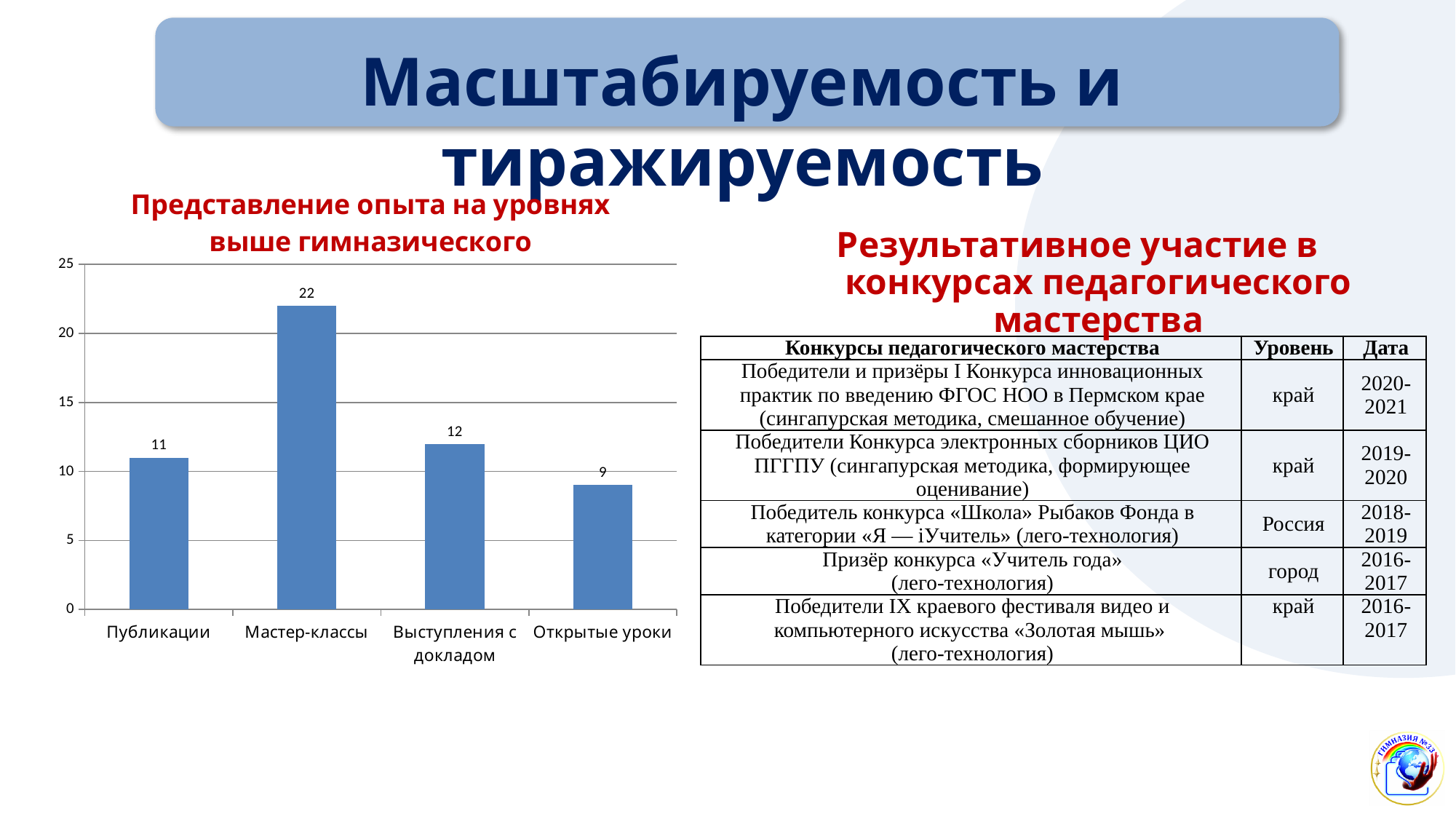
What is the value for Публикации? 11 What is the value for Мастер-классы? 22 What kind of chart is shown on the slide? Bar chart How many categories are shown in the chart? 4 What is the value for Открытые уроки? 9 What is the difference between the values for Выступления с докладом and Открытые уроки? 3 Which is larger, the value for Публикации or the value for Открытые уроки? Публикации Which category has the highest value? Мастер-классы What is the difference between the values for Мастер-классы and Публикации? 11 What is the title of the chart? Представление опыта на уровнях выше гимназического Which category has the lowest value? Открытые уроки What is the value for Выступления с докладом? 12